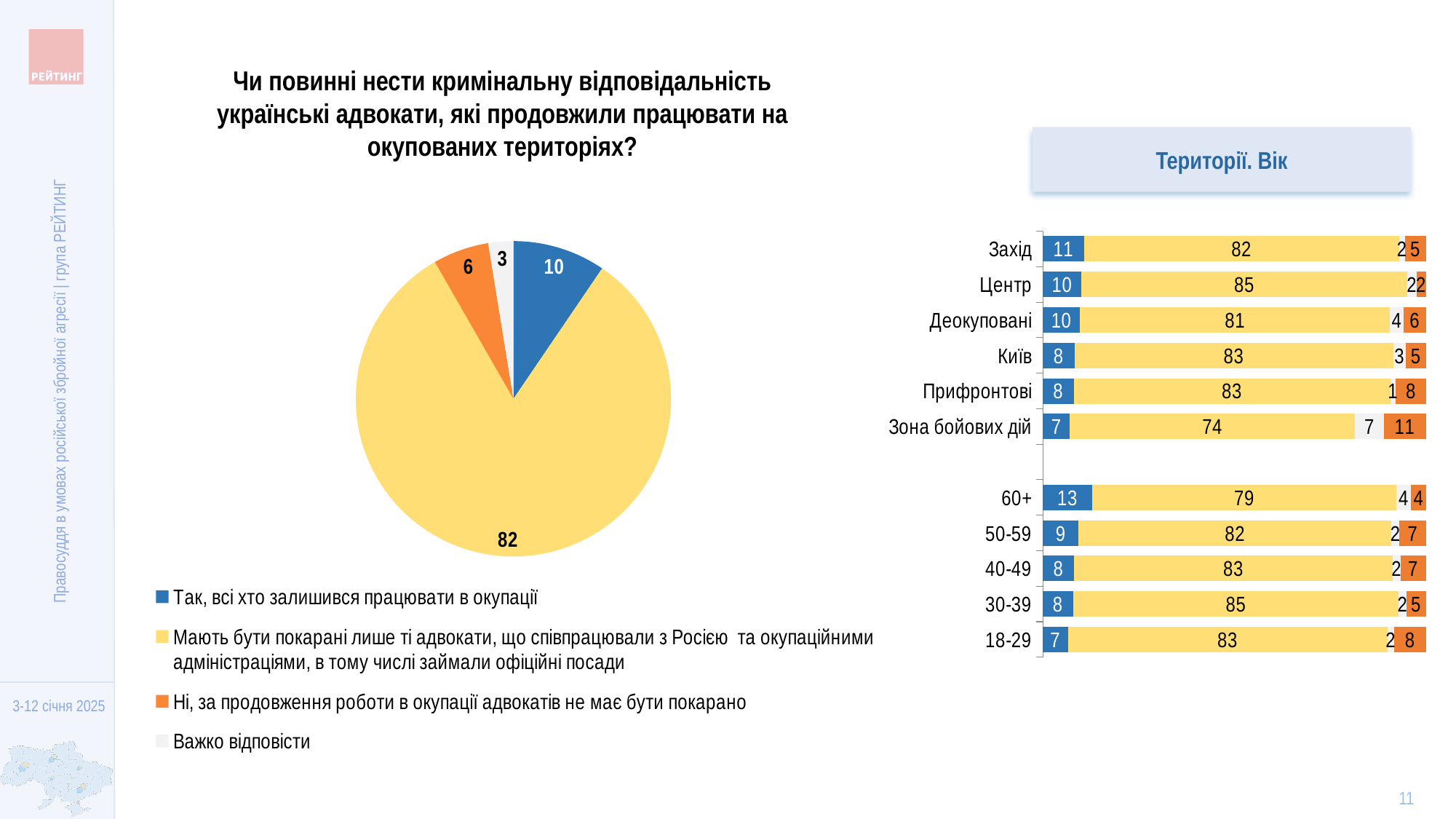
In the pie chart on the left, which answer has the smallest slice? Важко відповісти In the pie chart on the left, what is the value of the largest slice? 82 What type of chart is the "Території. Вік" chart? Stacked bar chart What type of chart is shown on the left of the slide? Pie chart In the pie chart on the left, how many slices are there? 4 In the "Території. Вік" chart, which category has the highest value in the orange segment? Зона бойових дій In the "Території. Вік" chart, how many category bars are shown? 11 In the "Території. Вік" chart, which has a larger blue segment value: "Захід" or "Київ"? Захід In the "Території. Вік" chart, what is the value of the yellow segment for "Зона бойових дій"? 74 In the "Території. Вік" chart, what is the value of the blue segment for "60+"? 13 In the "Території. Вік" chart, what is the difference between the yellow segment values for "Центр" and "Зона бойових дій"? 11 In the pie chart on the left, what share of respondents answered "Так, всі хто залишився працювати в окупації"? 10